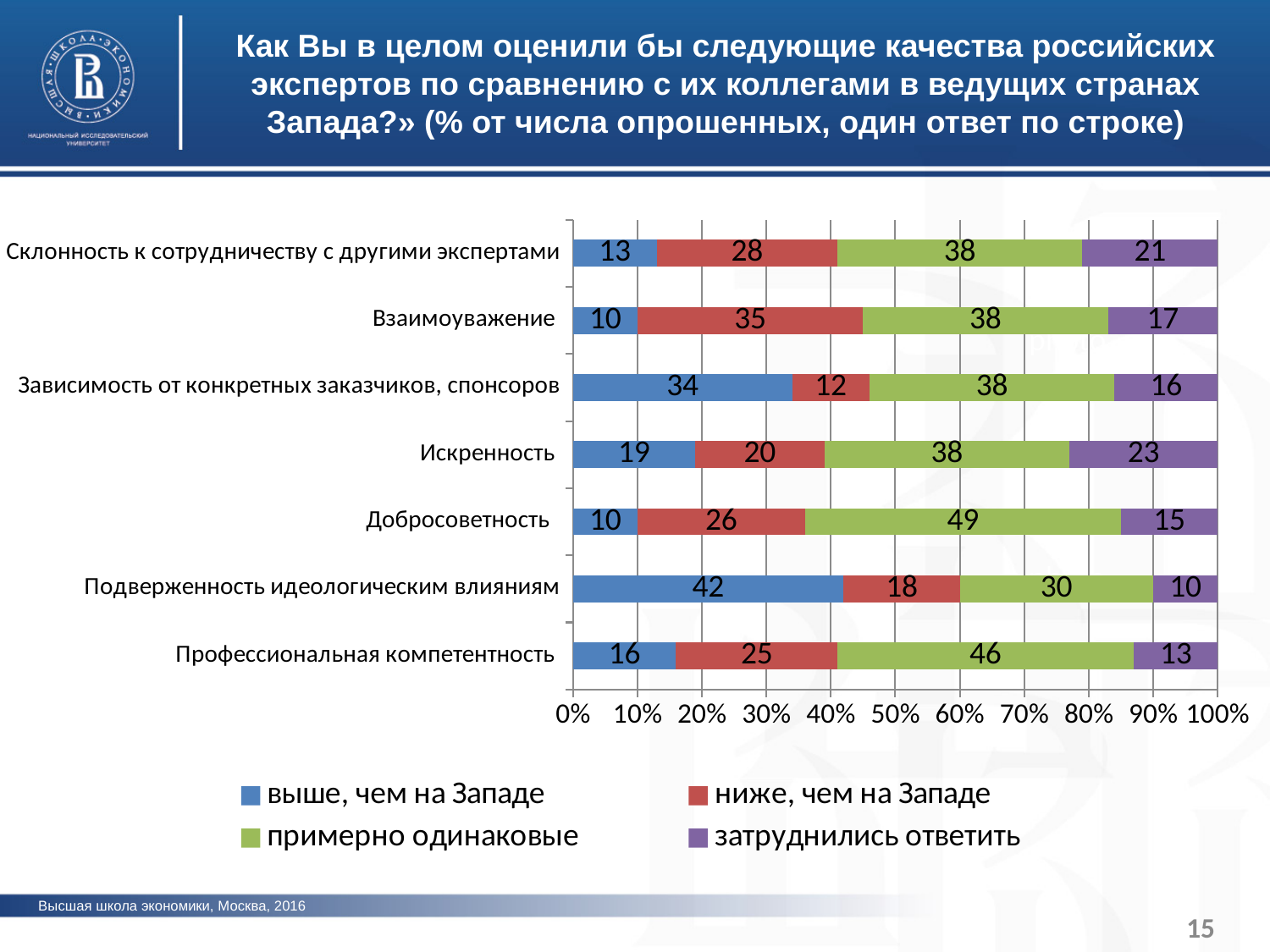
Which is larger: the 'выше, чем на Западе' value for 'Зависимость от конкретных заказчиков, спонсоров' or for 'Искренность'? Зависимость от конкретных заказчиков, спонсоров What is the value of 'выше, чем на Западе' for 'Подверженность идеологическим влияниям'? 42 Which category has the lowest value for 'ниже, чем на Западе'? Зависимость от конкретных заказчиков, спонсоров Which category has the highest value for 'выше, чем на Западе'? Подверженность идеологическим влияниям How many categories (qualities) are plotted on the chart? 7 What is the value of 'ниже, чем на Западе' for 'Взаимоуважение'? 35 How many series does the legend list? 4 What is the value of 'примерно одинаковые' for 'Добросоветность'? 49 What is the difference between the 'примерно одинаковые' values for 'Добросоветность' and 'Профессиональная компетентность'? 3 What type of chart is shown on the slide? stacked bar chart What is the total of the stacked bar for 'Профессиональная компетентность'? 100 What is the value of 'затруднились ответить' for 'Искренность'? 23